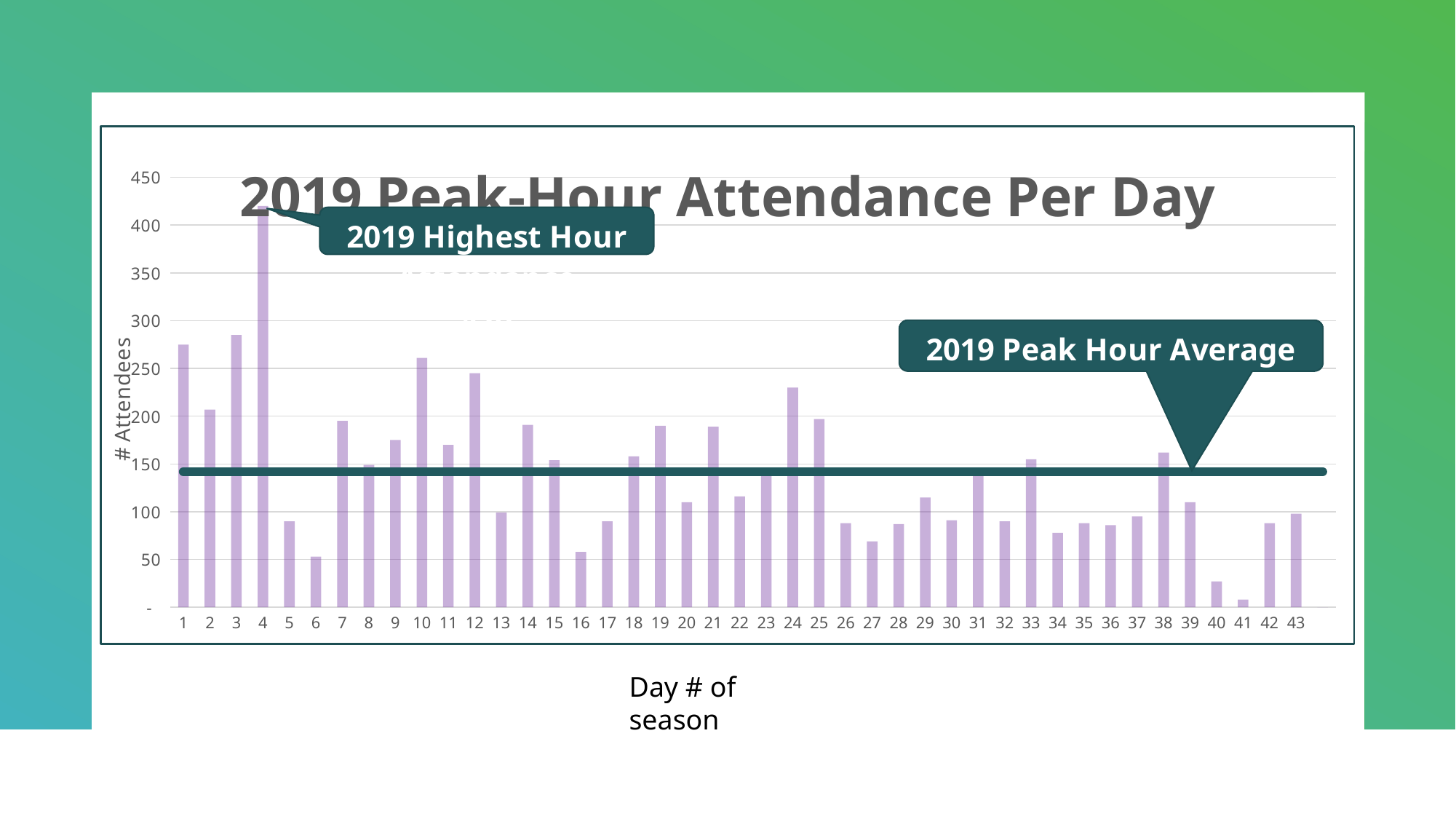
Is the value for day 24 greater or less than 200? greater Is the value for day 4 greater or less than 400? greater What is the title of the chart? 2019 Peak-Hour Attendance Per Day Is the value for day 6 greater or less than 100? less How many days are plotted along the x axis of the chart? 43 Which day of the season has the highest peak-hour attendance? 4 What is the label of the vertical axis? # Attendees Which day of the season has the lowest peak-hour attendance? 41 Which has the higher peak-hour attendance, day 2 or day 3? day 3 What kind of chart is shown on the slide? bar chart